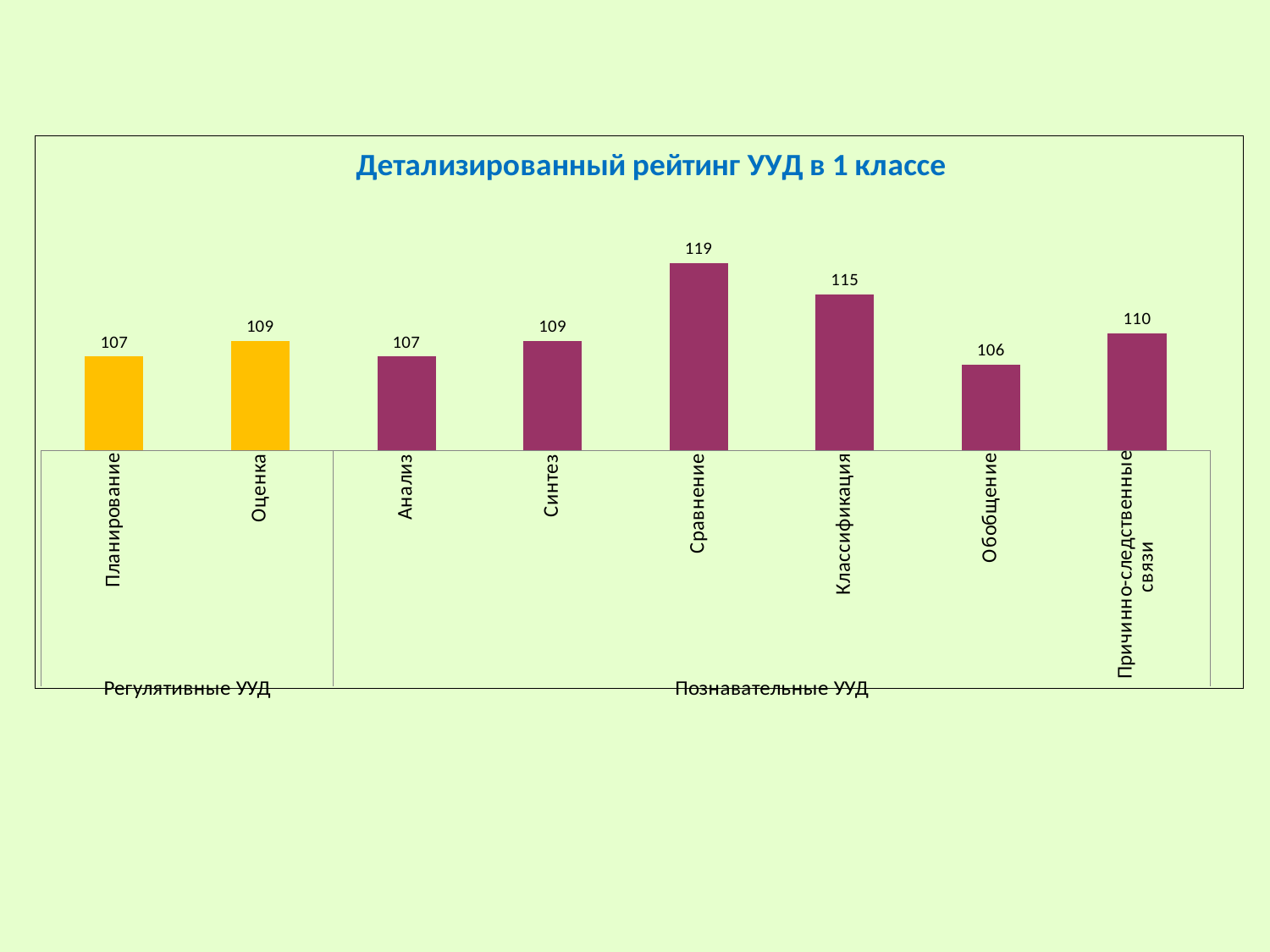
What is the difference between the values for Сравнение and Классификация? 4 What is the value for Обобщение? 106 Which is larger, the value for Классификация or the value for Синтез? Классификация What is the title of the chart? Детализированный рейтинг УУД в 1 классе What is the value for Сравнение? 119 How many categories are shown in the chart? 8 What is the value for Планирование? 107 Which category has the highest value? Сравнение Which category has the lowest value? Обобщение What is the value for Причинно-следственные связи? 110 What is the difference between the values for Оценка and Планирование? 2 What kind of chart is this? Bar chart